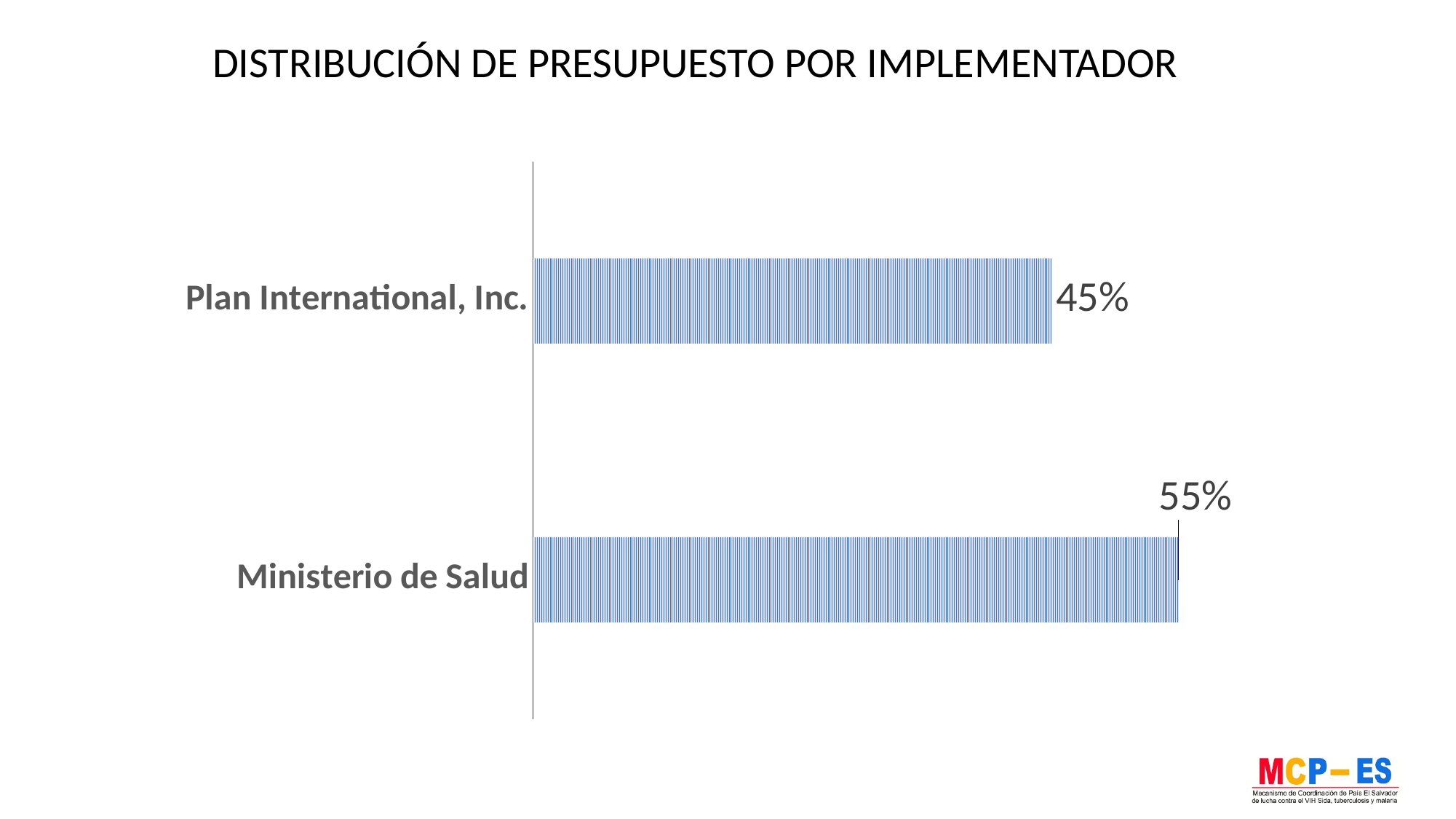
What is the difference between the values for Ministerio de Salud and Plan International, Inc.? 10% Which implementer has the lowest budget share? Plan International, Inc. What kind of chart is shown on the slide? Bar chart How many categories are shown in the chart? 2 Which implementer has the highest budget share? Ministerio de Salud Are the bars in the chart oriented horizontally or vertically? Horizontally What is the title of the chart? DISTRIBUCIÓN DE PRESUPUESTO POR IMPLEMENTADOR What is the total of the two values shown in the chart? 100% What is the value for Plan International, Inc.? 45% What is the value for Ministerio de Salud? 55% Which is larger, the value for Plan International, Inc. or the value for Ministerio de Salud? Ministerio de Salud